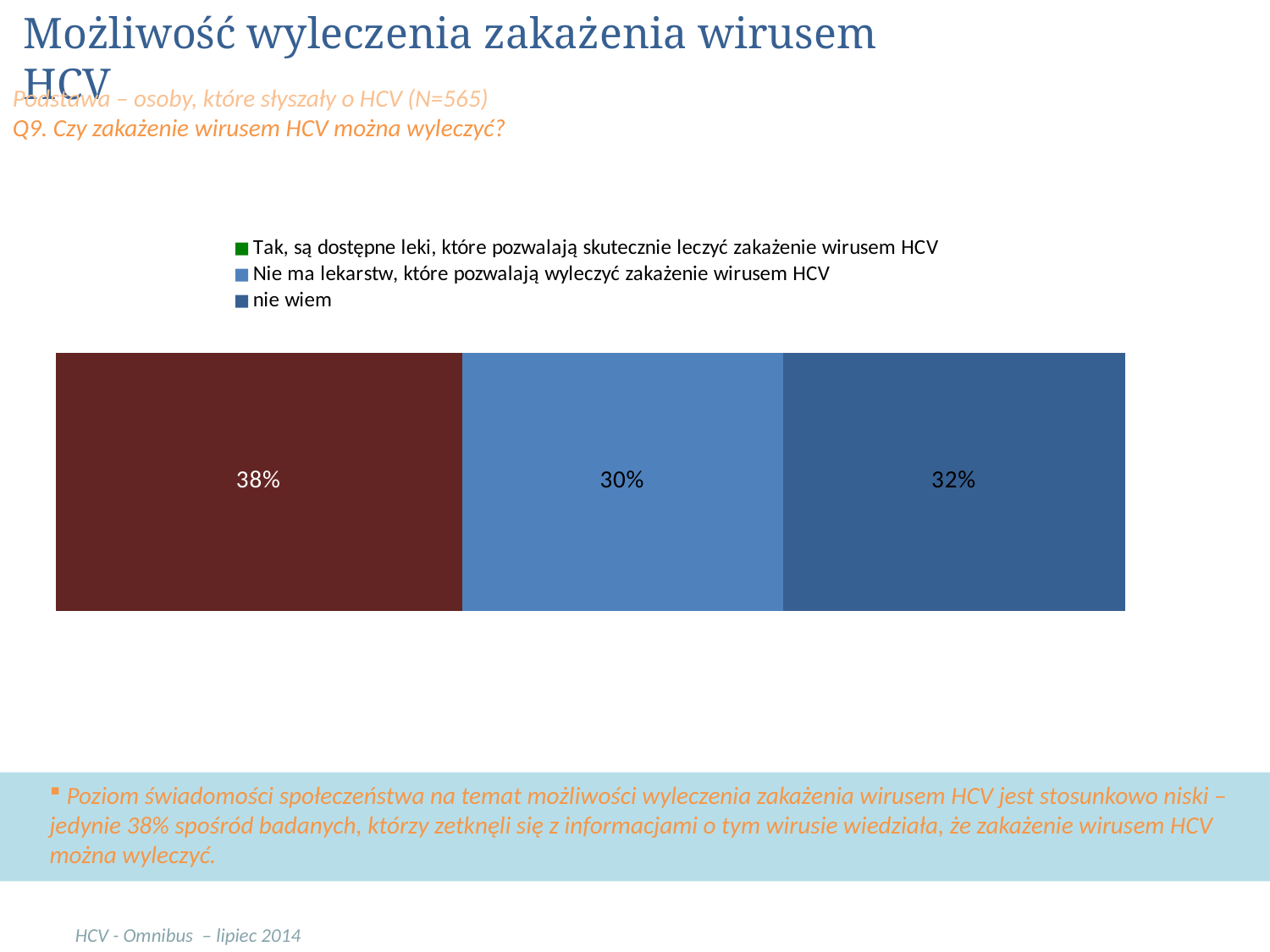
What is the difference in percentage points between the "Tak, są dostępne leki" segment and the "nie wiem" segment? 6 How many segments does the stacked bar contain? 3 What percentage of respondents said there are no medicines to cure HCV infection ("Nie ma lekarstw...")? 30% Which response has the largest share in the bar? Tak, są dostępne leki, które pozwalają skutecznie leczyć zakażenie wirusem HCV What type of chart is shown on the slide? Stacked bar chart How many entries does the legend list? 3 What is the sample size (N) stated in the subtitle of the chart? N=565 What percentage of respondents said there are medicines that effectively treat HCV infection ("Tak, są dostępne leki...")? 38% Which response has the smallest share in the bar? Nie ma lekarstw, które pozwalają wyleczyć zakażenie wirusem HCV What percentage of respondents answered "nie wiem"? 32% Which is larger: the "nie wiem" segment or the "Nie ma lekarstw" segment? nie wiem What is the total of the three segments in the stacked bar? 100%